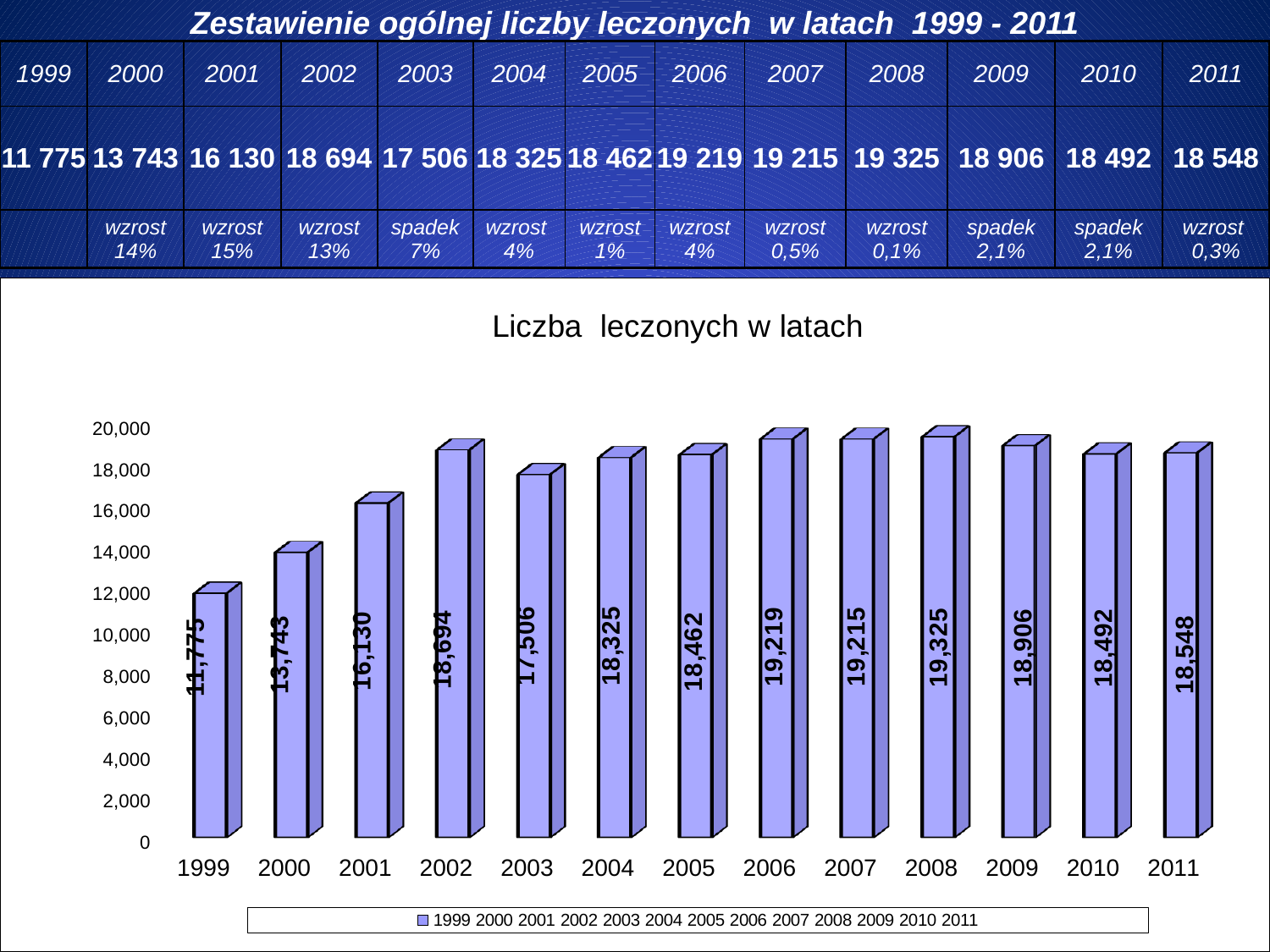
Is the value for 2001 greater or less than 18,000? less Which year has the lowest value in the chart? 1999 How many years (bars) are plotted in the chart? 13 What kind of chart is shown on the slide? bar chart Which is larger, the value for 2002 or the value for 2003? 2002 What is the value shown for 2003 in the chart? 17,506 What is the difference between the values for 2000 and 1999? 1,968 Which year has the highest value in the chart? 2008 What is the title of the chart? Liczba leczonych w latach What is the value shown for 2011 in the chart? 18,548 Do the values rise or fall from 1999 to 2002? rise What is the difference between the values for 2002 and 2003? 1,188